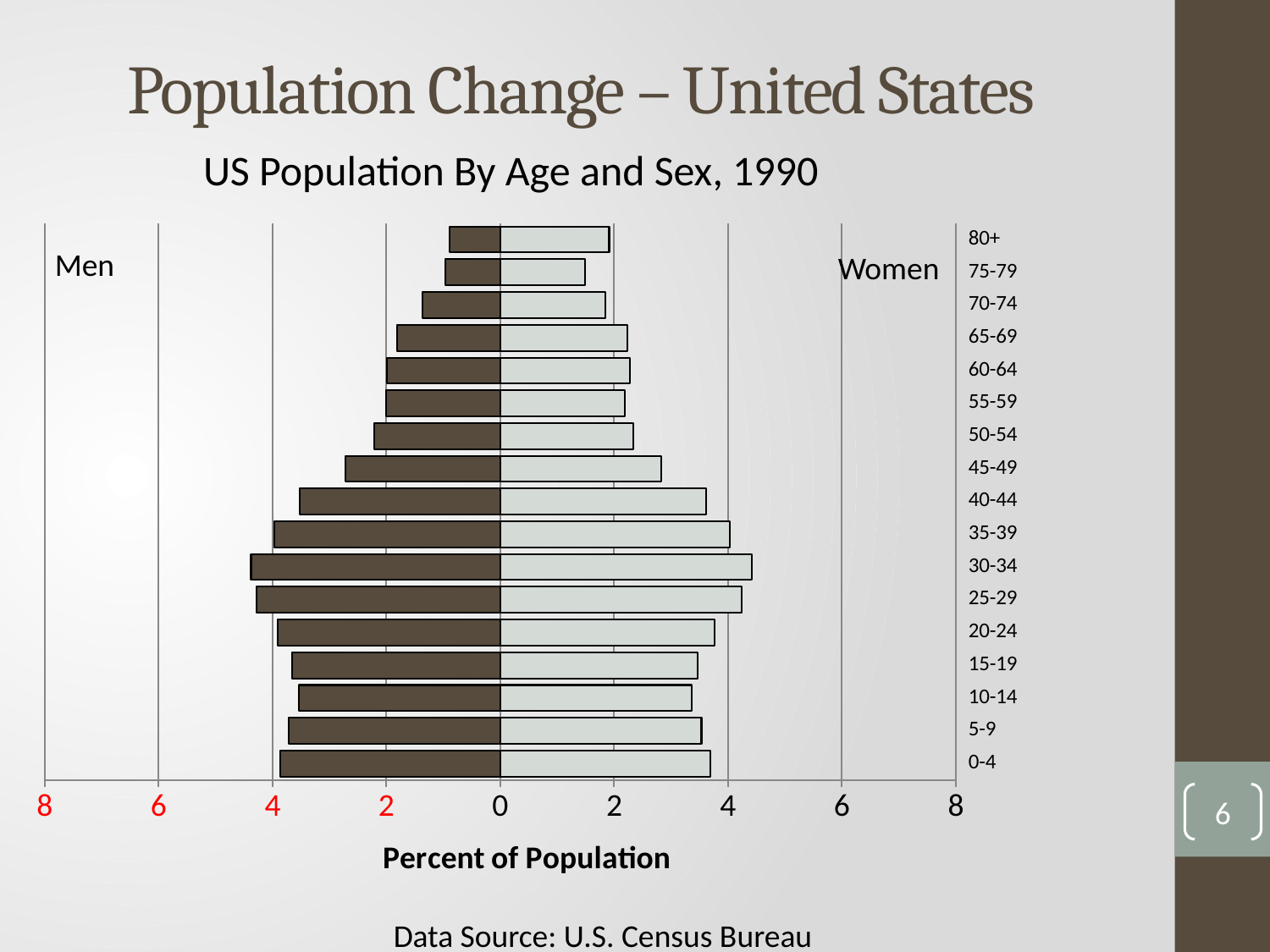
How many age groups are shown on the chart? 17 What is the title of the chart? US Population By Age and Sex, 1990 What kind of chart is shown on the slide? bar chart Which age group has the shortest bar for Men? 80+ Which age group has the shortest bar for Women? 75-79 What is the label of the horizontal axis? Percent of Population Is the value for Women aged 45-49 greater or less than 4? less Which age group has the longest bar for Women? 30-34 For the 80+ age group, which is larger, the Men bar or the Women bar? Women Which age group has the longest bar for Men? 30-34 Is the value for Men aged 30-34 greater or less than 4? greater Is the value for Men aged 80+ greater or less than 2? less